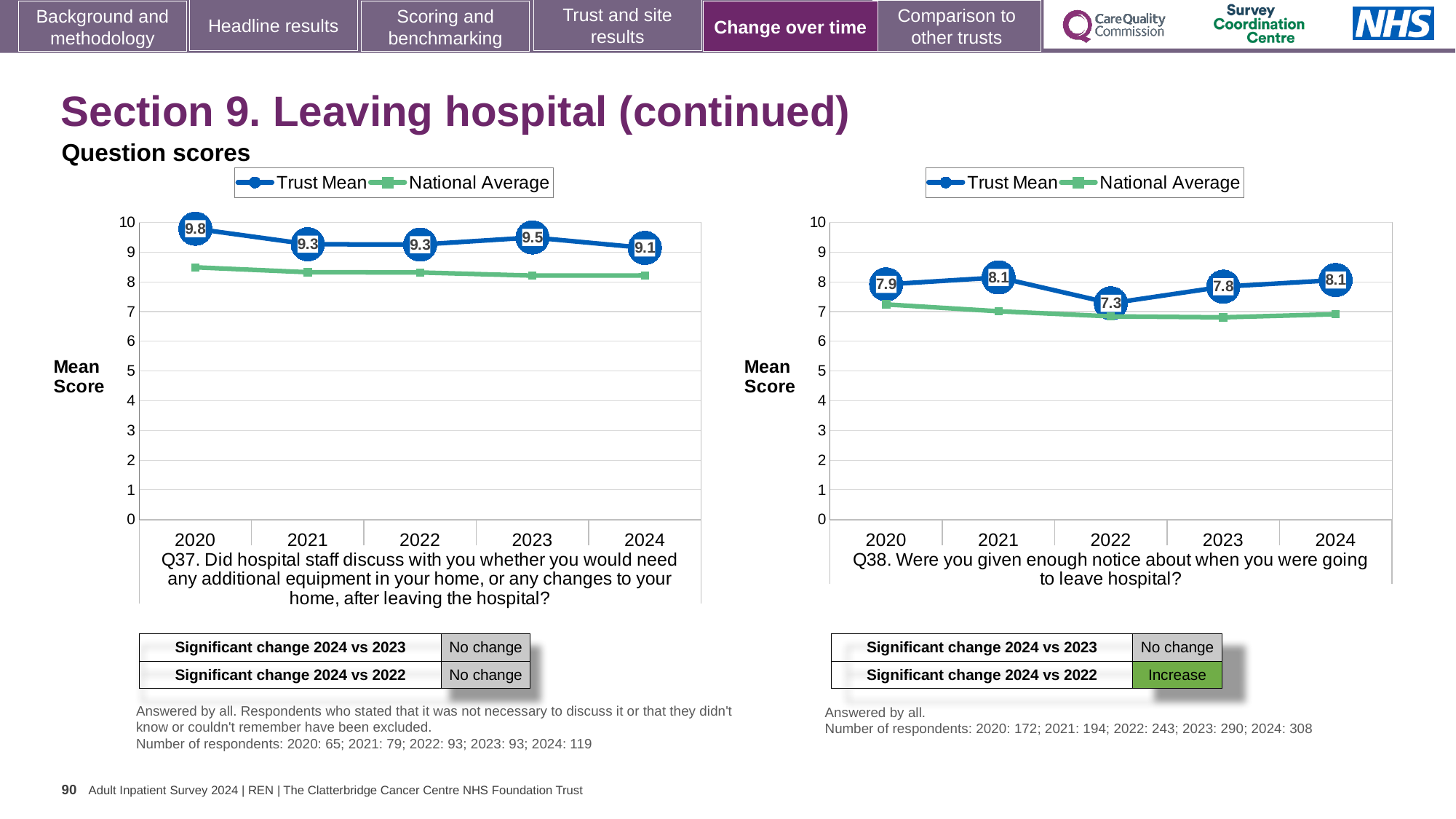
How many series does the legend of the Q37 chart (left) list? 2 In the Q37 chart (left), what is the Trust Mean score for 2020? 9.8 In the Q37 chart (left), does the Trust Mean score rise or fall from 2023 to 2024? Fall In the Q37 chart (left), is the National Average value for 2020 greater or less than 8? greater In the Q38 chart (right), which year has the lowest Trust Mean score? 2022 In the Q37 chart (left), what is the difference between the Trust Mean scores for 2020 and 2024? 0.7 What kind of chart is the Q37 chart (left)? Line chart How many years are shown on the x axis of the Q38 chart (right)? 5 In the Q37 chart (left), which year has the highest Trust Mean score? 2020 In the Q38 chart (right), which is larger, the Trust Mean score for 2021 or for 2023? 2021 In the Q38 chart (right), what is the Trust Mean score for 2022? 7.3 In the Q38 chart (right), is the National Average value for 2023 greater or less than 7? less